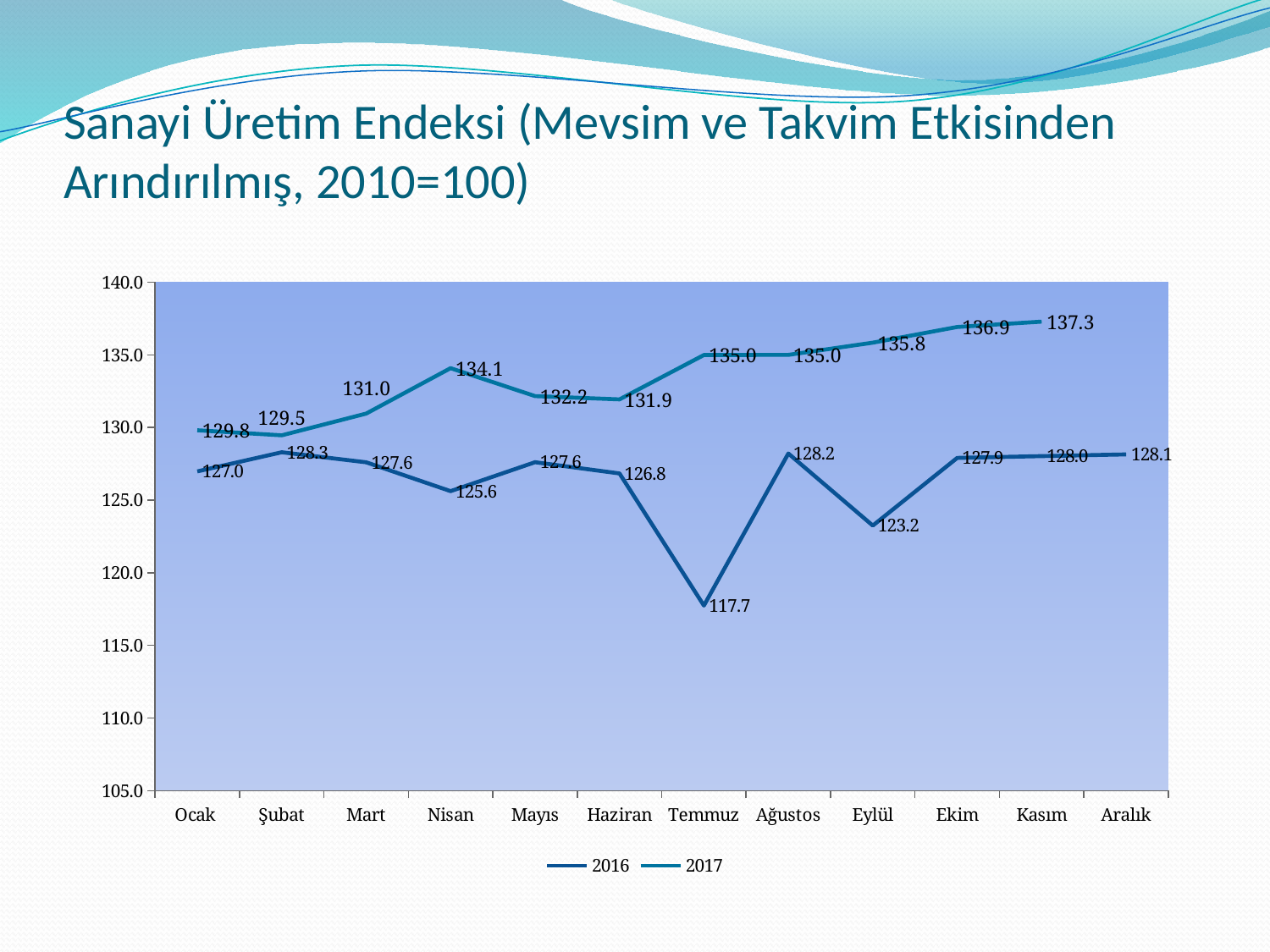
How many months are shown on the x axis? 12 In which month is the 2016 value lowest? Temmuz Does the 2017 series generally rise or fall from Ocak to Kasım? Rise Which is larger, the 2017 value for Mayıs or the 2017 value for Haziran? Mayıs What is the 2016 value for Eylül? 123.2 What is the difference between the 2016 values for Ağustos and Eylül? 5.0 What is the 2016 value for Temmuz? 117.7 In which month is the 2017 value highest? Kasım What is the 2017 value for Nisan? 134.1 How many series does the legend list? 2 What is the difference between the 2017 and 2016 values for Ocak? 2.8 What type of chart is shown on the slide? Line chart